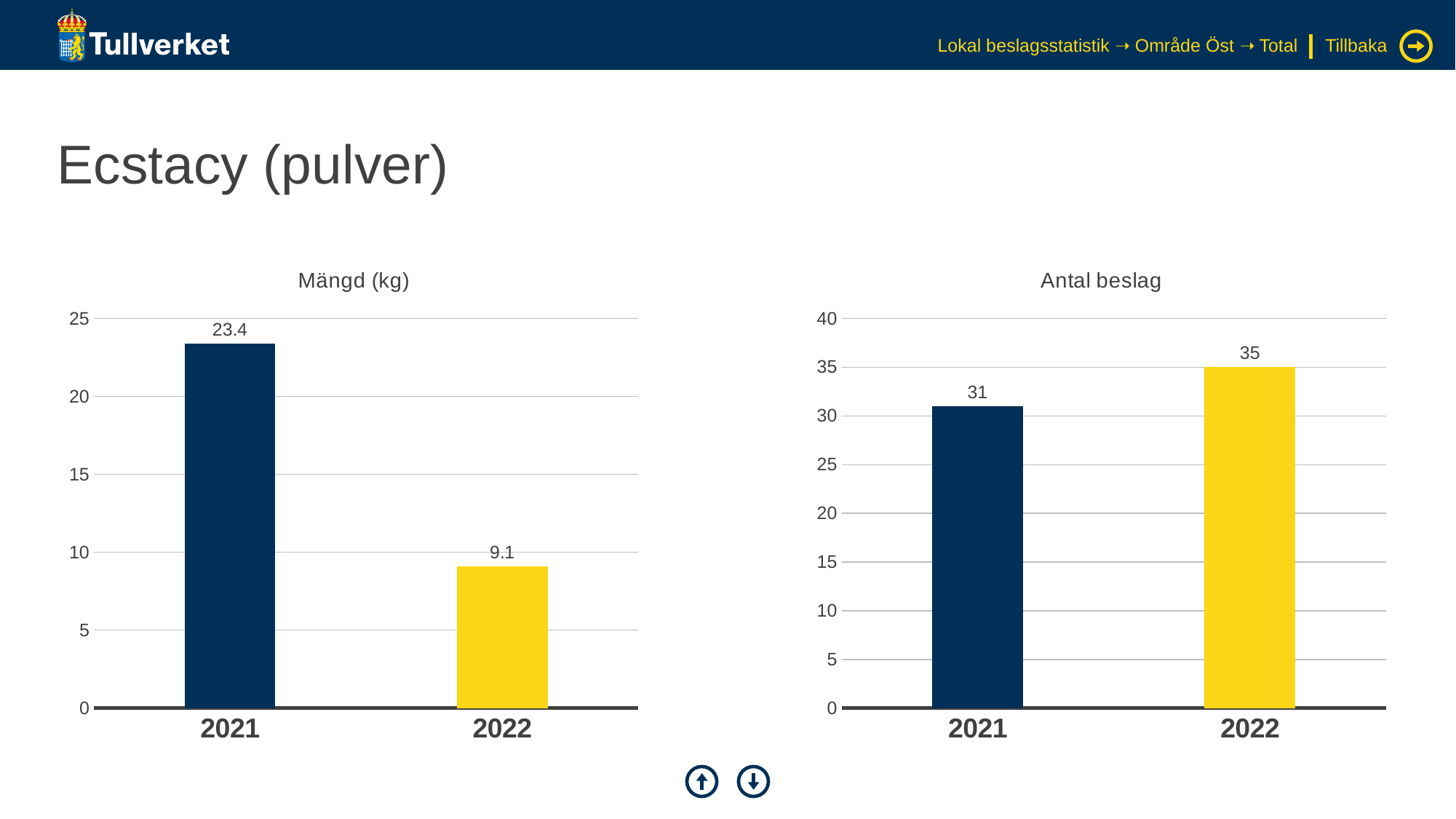
In the 'Antal beslag' chart, what is the difference between the 2022 and 2021 values? 4 In the 'Antal beslag' chart, what is the value for 2022? 35 In the 'Antal beslag' chart, is the value for 2022 greater or less than 30? greater In the 'Antal beslag' chart, which year has the lowest value? 2021 In the 'Mängd (kg)' chart, which year has the highest value? 2021 In the 'Antal beslag' chart, what is the value for 2021? 31 In the 'Mängd (kg)' chart, what is the value for 2021? 23.4 How many categories are shown in the 'Antal beslag' chart? 2 In the 'Mängd (kg)' chart, what is the value for 2022? 9.1 In the 'Mängd (kg)' chart, what is the difference between the 2021 and 2022 values? 14.3 What kind of chart is the 'Mängd (kg)' chart? bar chart In the 'Mängd (kg)' chart, do the values rise or fall from 2021 to 2022? fall